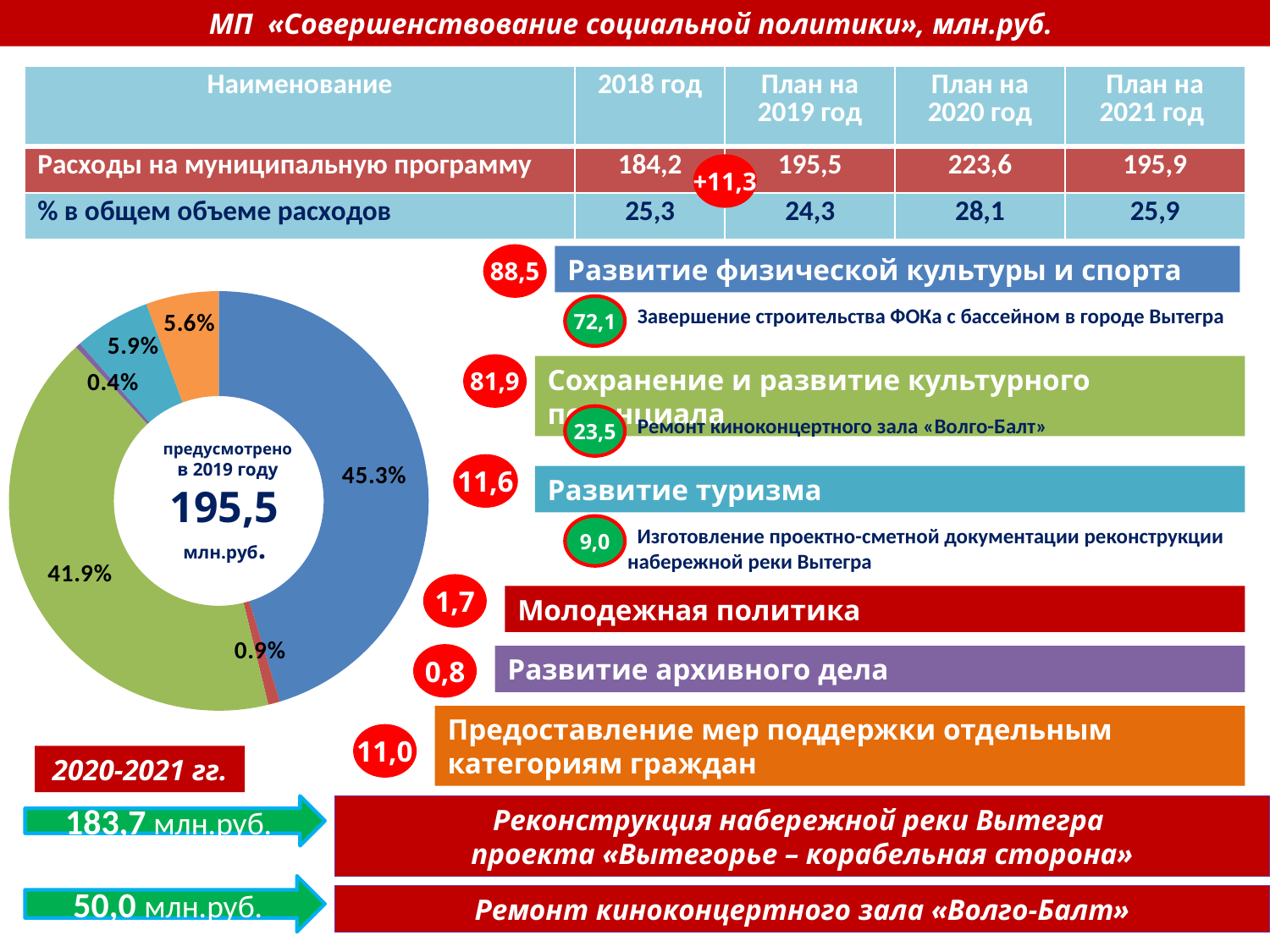
What kind of chart is shown on the left of the slide? Pie (donut) chart What is the smallest percentage shown on the donut chart? 0.4% What is the difference in percentage points between the two largest slices of the donut chart (45.3% and 41.9%)? 3.4 What is the largest percentage shown on the donut chart? 45.3% What total amount is printed in the centre of the donut chart? 195,5 млн.руб. Which is larger on the donut chart: the slice labelled 0.9% or the slice labelled 0.4%? 0.9% Which is larger on the donut chart: the slice labelled 5.9% or the slice labelled 5.6%? 5.9% What percentage is shown for the green slice of the donut chart? 41.9% According to the centre text of the donut chart, for which year is the amount planned? 2019 How many slices does the donut chart have? 6 What is the combined share of the two slices labelled 5.9% and 5.6% on the donut chart? 11.5% What colour is the largest slice (45.3%) of the donut chart? Blue